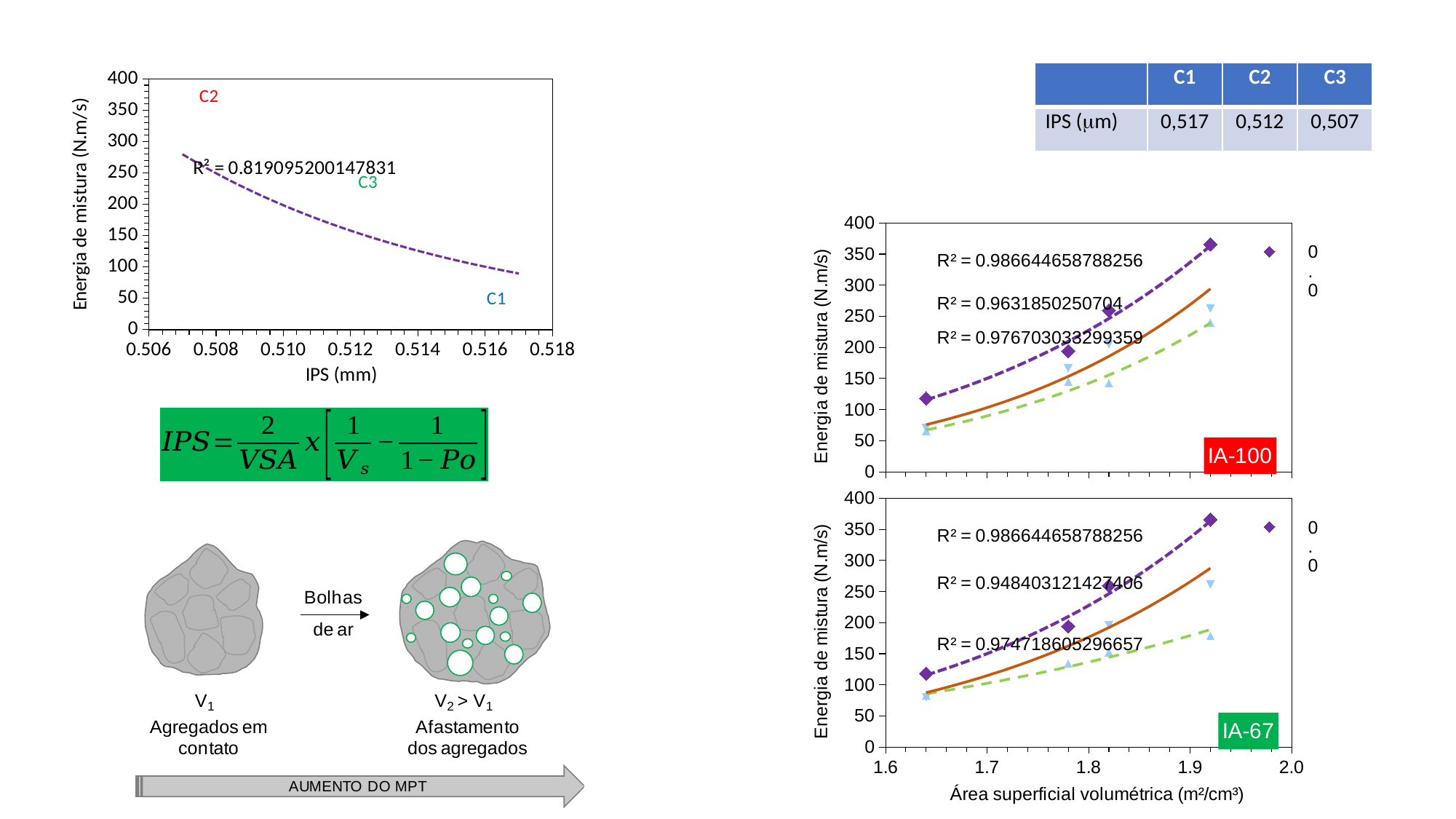
In the IA-67 chart, is the value of the purple diamond series at x = 1.92 greater or less than 300? greater In the IA-100 chart, is the value of the purple diamond series at x = 1.64 greater or less than 150? less In the top-left chart, what is the R² value printed on the chart? 0.819095200147831 In the IA-100 chart, what is the largest R² value printed? 0.986644658788256 What is the x-axis title of the IA-67 chart? Área superficial volumétrica (m²/cm³) In the IA-100 chart, does the mixing energy rise or fall as the volumetric surface area increases? rise What is the x-axis title of the top-left chart? IPS (mm) In the IA-100 chart, what is the smallest R² value printed? 0.9631850250704 In the IA-67 chart, what is the R² value printed for the green dashed trendline (the lowest one)? 0.974718605296657 In the top-left chart, what is the highest value shown on the y axis? 400 In the top-left chart, does the mixing energy (Energia de mistura) rise or fall as IPS increases along the x axis? fall In the IA-67 chart, what is the smallest R² value printed? 0.948403121427406